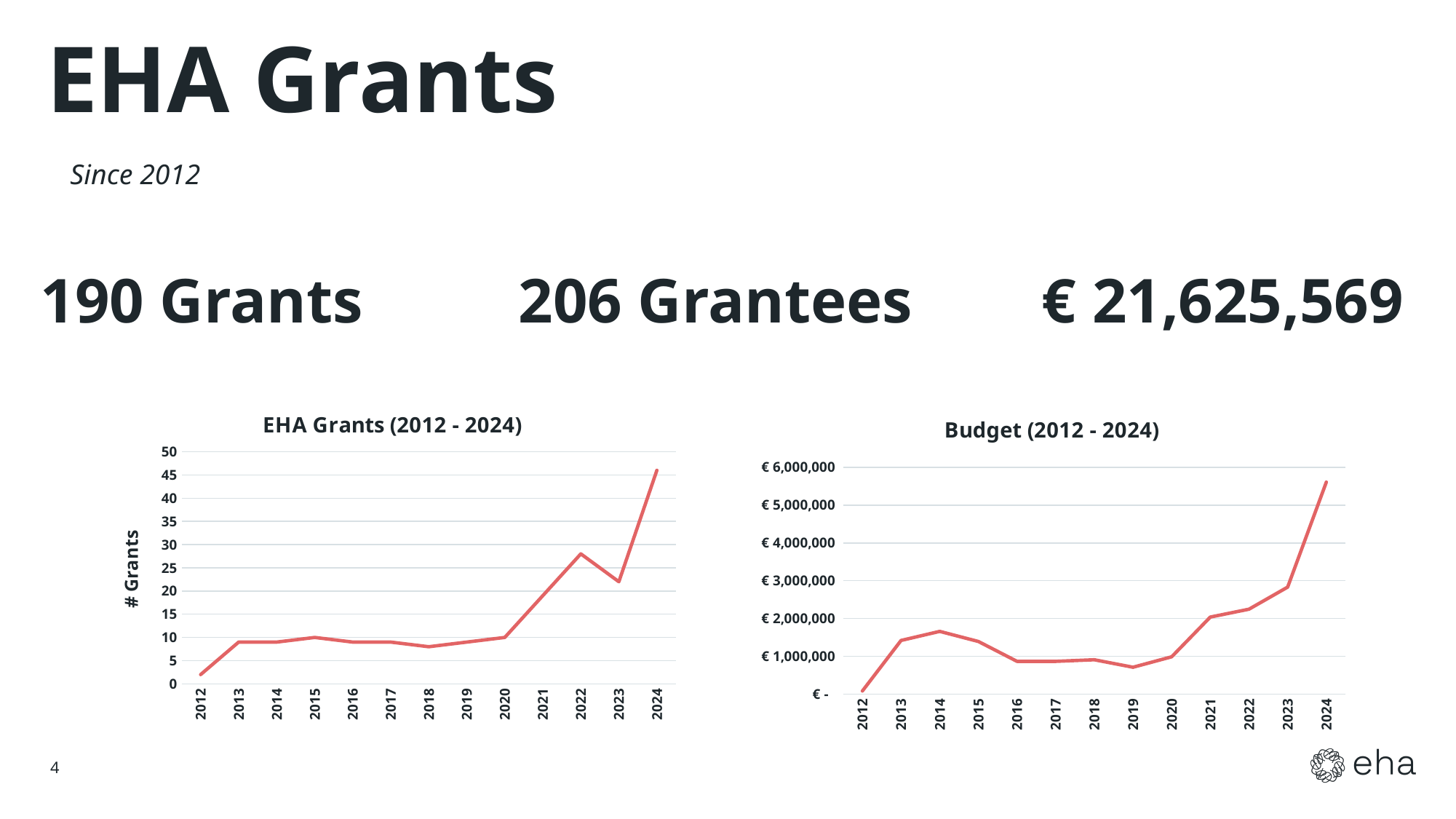
In the 'EHA Grants (2012 - 2024)' chart, is the value for 2024 greater or less than 40? greater In the 'EHA Grants (2012 - 2024)' chart, is the value for 2022 greater or less than 25? greater In the 'Budget (2012 - 2024)' chart, is the value for 2019 greater or less than € 1,000,000? less What type of chart is the 'EHA Grants (2012 - 2024)' chart? line chart In the 'Budget (2012 - 2024)' chart, which year has the lowest budget? 2012 In the 'EHA Grants (2012 - 2024)' chart, which year has the highest number of grants? 2024 In the 'EHA Grants (2012 - 2024)' chart, which year has more grants, 2022 or 2023? 2022 In the 'Budget (2012 - 2024)' chart, which year has the highest budget? 2024 What type of chart is the 'Budget (2012 - 2024)' chart? line chart How many years are plotted on the x axis of the 'Budget (2012 - 2024)' chart? 13 In the 'EHA Grants (2012 - 2024)' chart, which year has the lowest number of grants? 2012